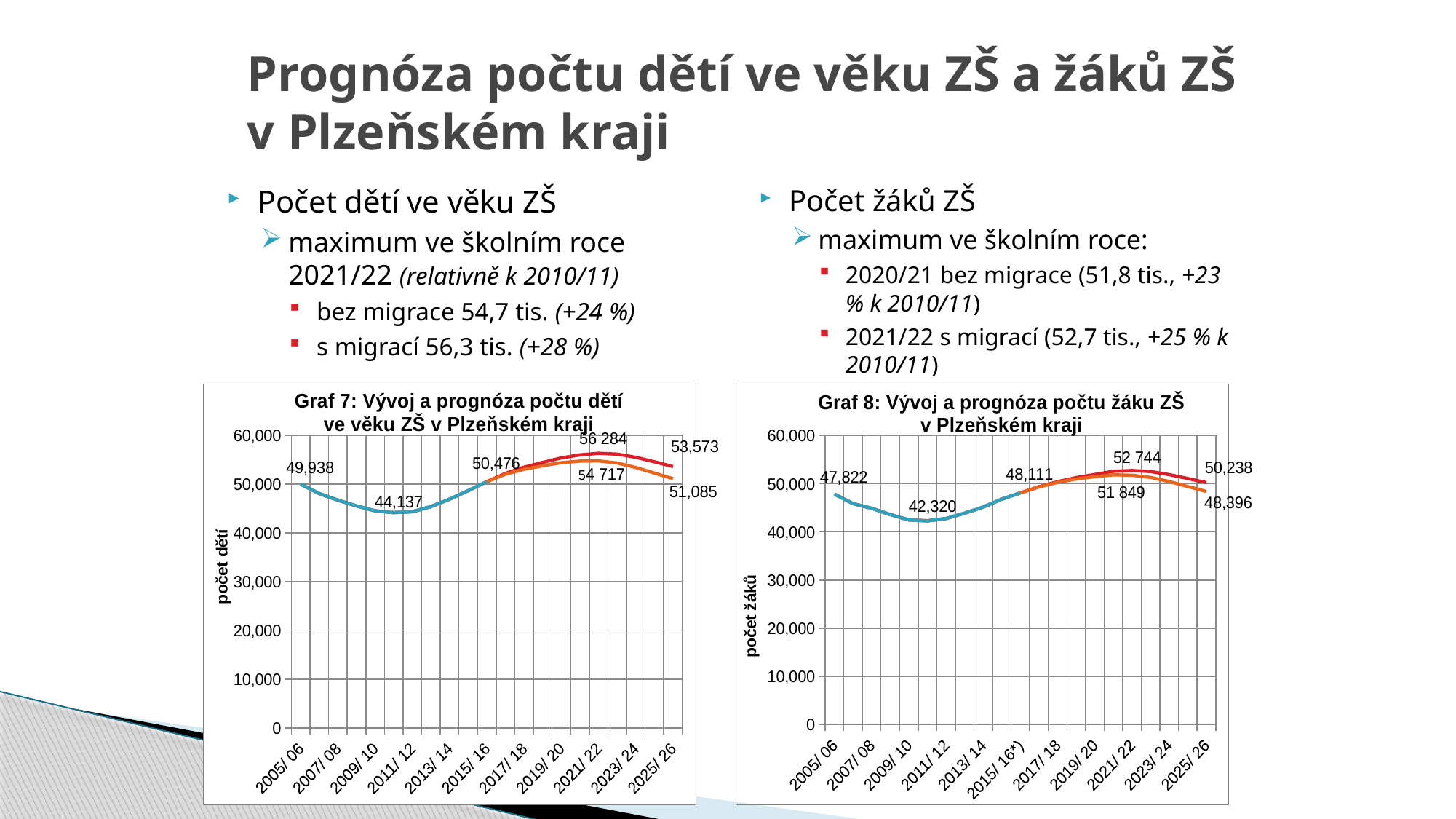
In Graf 8, what is the value labelled where the blue line ends and the forecast lines begin? 48,111 In Graf 8, what is the value labelled for 2005/06? 47,822 In Graf 7, what is the difference between the two end values for 2025/26, 53,573 and 51,085? 2,488 In Graf 8, what is the difference between the two labelled peak values, 52 744 and 51 849? 895 What type of chart is Graf 7? line chart In Graf 7, what is the value labelled at the start of the series for 2005/06? 49,938 In Graf 8, which end value for 2025/26 is larger, the red line's or the orange line's? the red line's (50,238) In Graf 7, what is the difference between the two labelled peak values, 56 284 and 54 717? 1 567 In Graf 7, what is the highest labelled value on the red line? 56 284 In Graf 7, what is the lowest labelled value on the blue line? 44,137 What is the y-axis title of Graf 8? počet žáků In Graf 8, what is the lowest labelled value on the blue line? 42,320